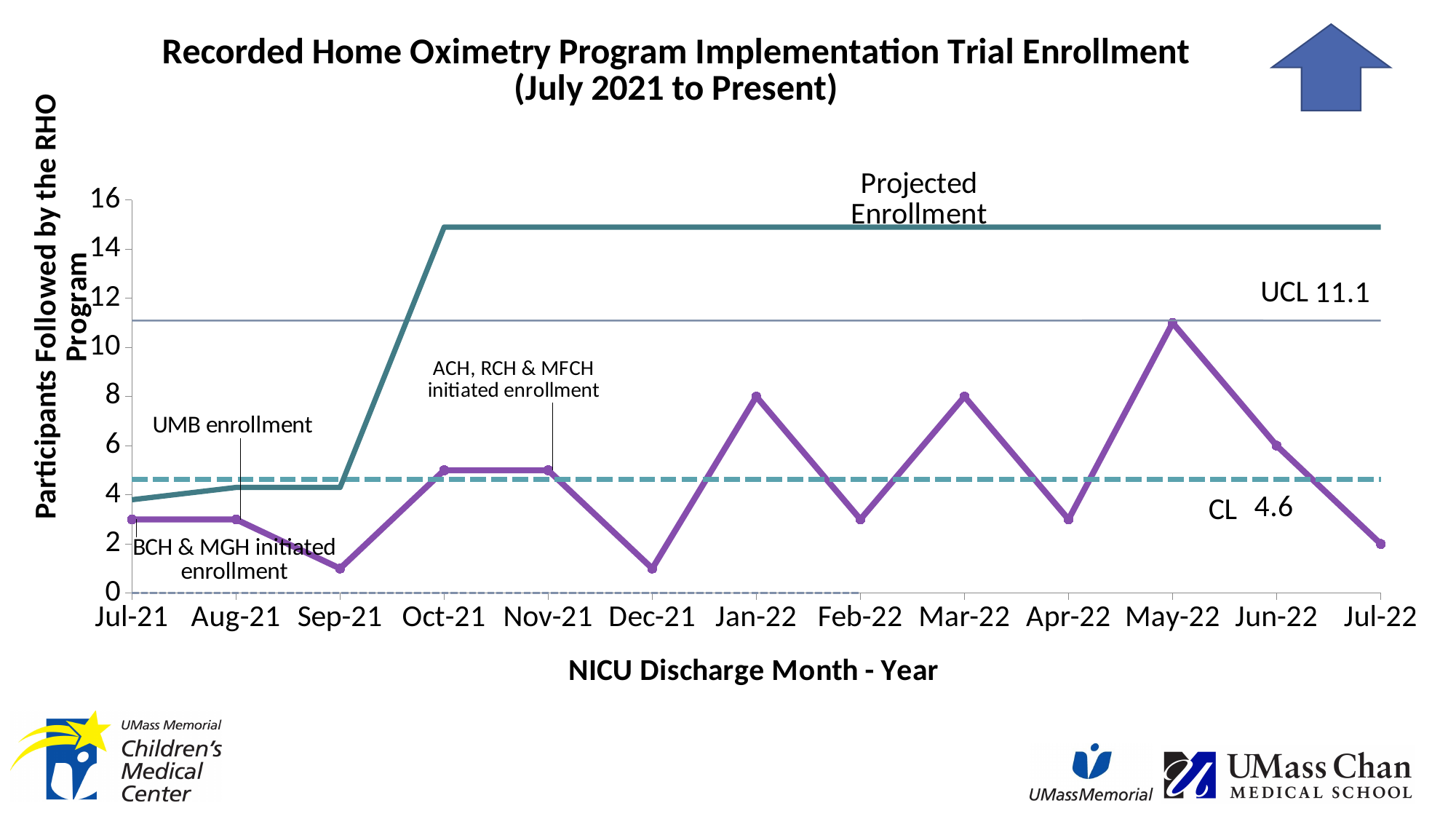
Is the value for May-22 greater or less than 10? greater What is the difference between the values for Jan-22 and Jul-22? 6 How many participants were followed by the RHO Program for Jan-22? 8 How many participants were followed by the RHO Program for Jun-22? 6 Is the value for Sep-21 greater or less than 2? less Which month has the highest number of participants followed by the RHO Program? May-22 What is the UCL value shown on the chart? 11.1 How many months are plotted on the x axis? 13 How many participants were followed by the RHO Program for Jul-22? 2 What is the CL value shown on the chart? 4.6 What kind of chart is shown on the slide? line chart What is the title of the chart? Recorded Home Oximetry Program Implementation Trial Enrollment (July 2021 to Present)